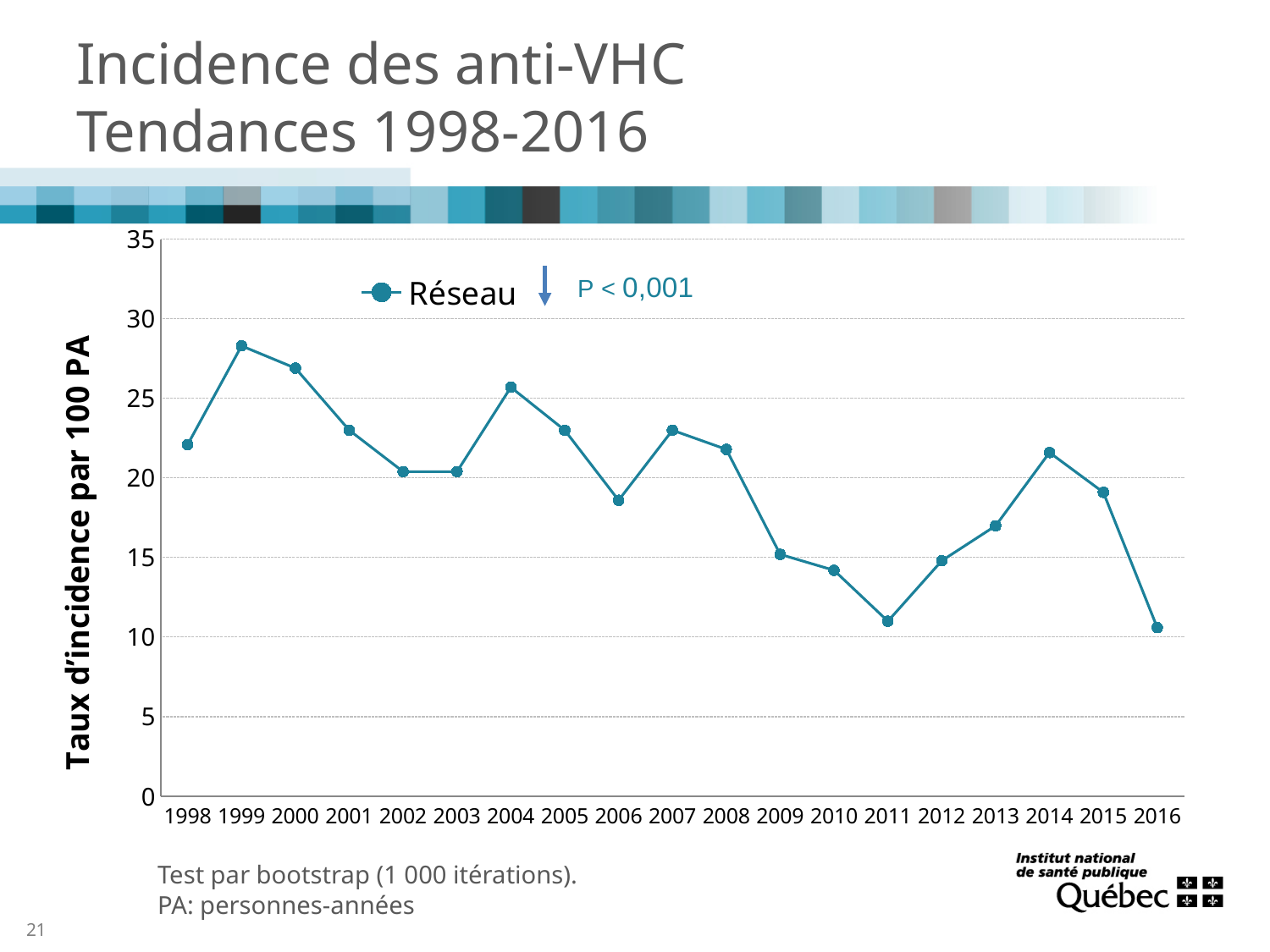
Which is larger, the value for 2004 or the value for 2006? 2004 Overall, do the values rise or fall from 1998 to 2016? fall Is the value for 2006 greater or less than 20? less Is the value for 1999 greater or less than 25? greater What kind of chart is shown on the slide? line chart Is the value for 2010 greater or less than 15? less How many series does the legend list? 1 What is the label of the vertical axis? Taux d'incidence par 100 PA How many years (data points) are plotted on the x axis? 19 Which year has the highest incidence rate? 1999 What is the name of the series shown in the legend? Réseau